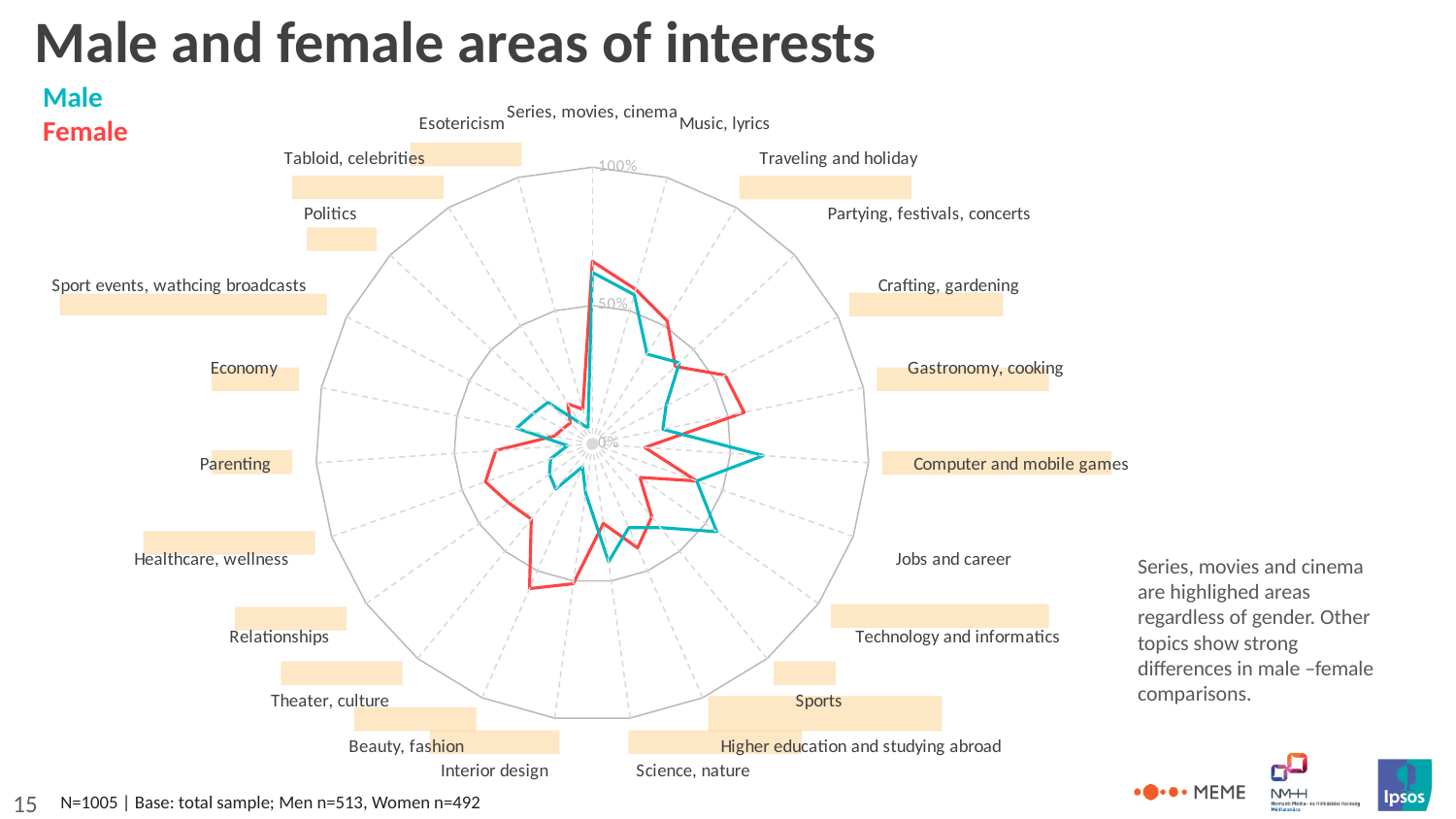
Which is larger for Beauty, fashion, the Male or the Female value? Female Is the Male value for Computer and mobile games greater or less than 50%? greater Which is larger for Computer and mobile games, the Male or the Female value? Male Which category has the highest Female value? Series, movies, cinema Which two series are plotted on the chart? Male and Female What colour is used for the Female series? Red Is the Male value for Series, movies, cinema greater or less than 50%? greater How many series does the chart's legend list? 2 Is the Female value for Parenting greater or less than 50%? less What kind of chart is shown on the slide? Radar chart Which is larger for Technology and informatics, the Male or the Female value? Male